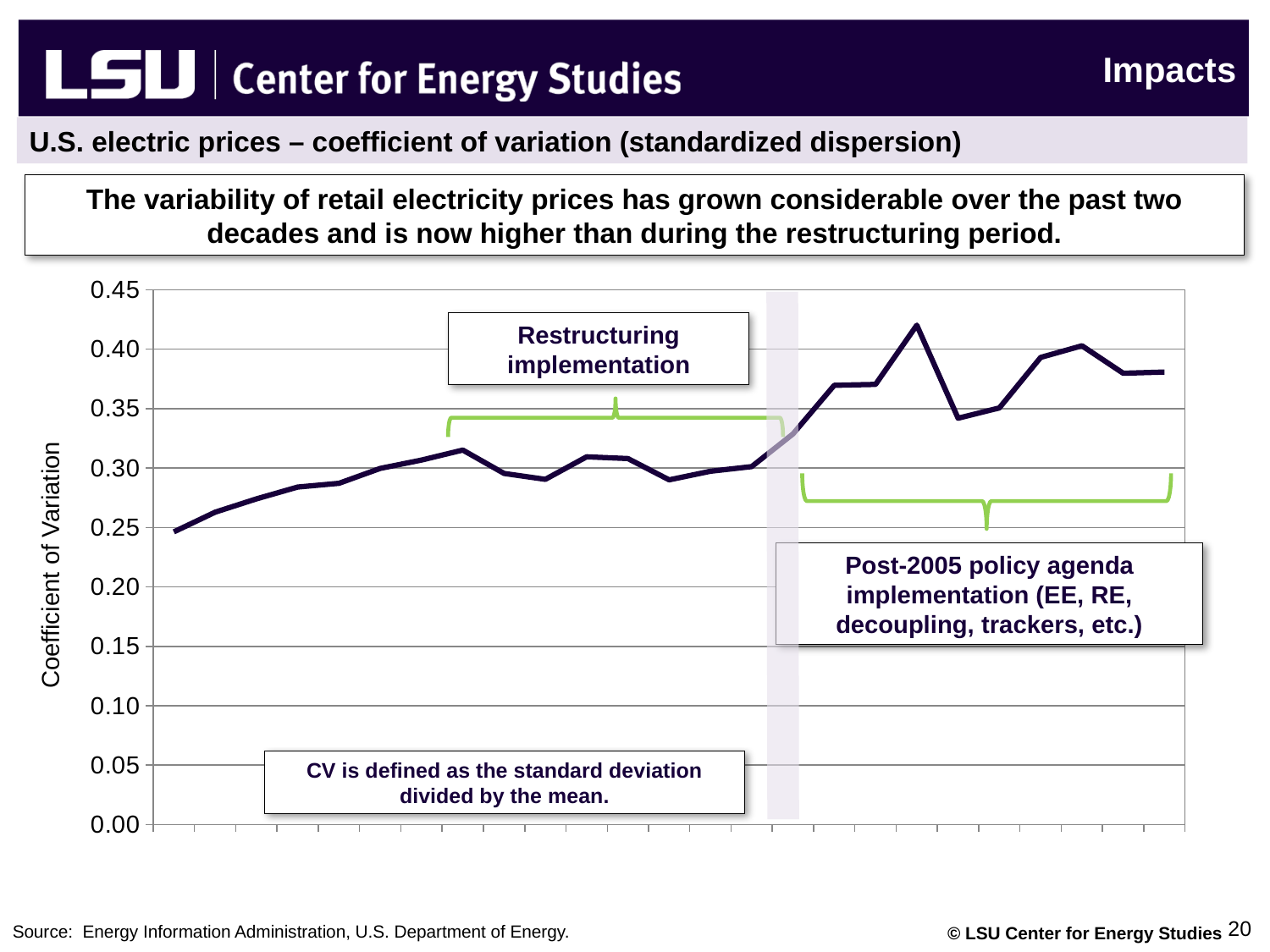
What is the label on the vertical axis of the chart? Coefficient of Variation Which is higher, the first point on the line or the last point on the line? the last point What kind of chart is shown on the slide? line chart Is the first point on the line greater or less than 0.30? less Are all points on the line during the restructuring implementation period greater or less than 0.35? less Is the highest point on the line greater or less than 0.40? greater What is the highest value shown on the vertical axis of the chart? 0.45 Which is higher, the peak of the line during the restructuring implementation period or the peak during the post-2005 policy agenda period? the post-2005 policy agenda period Overall, does the coefficient of variation rise or fall from the left of the chart to the right? rise